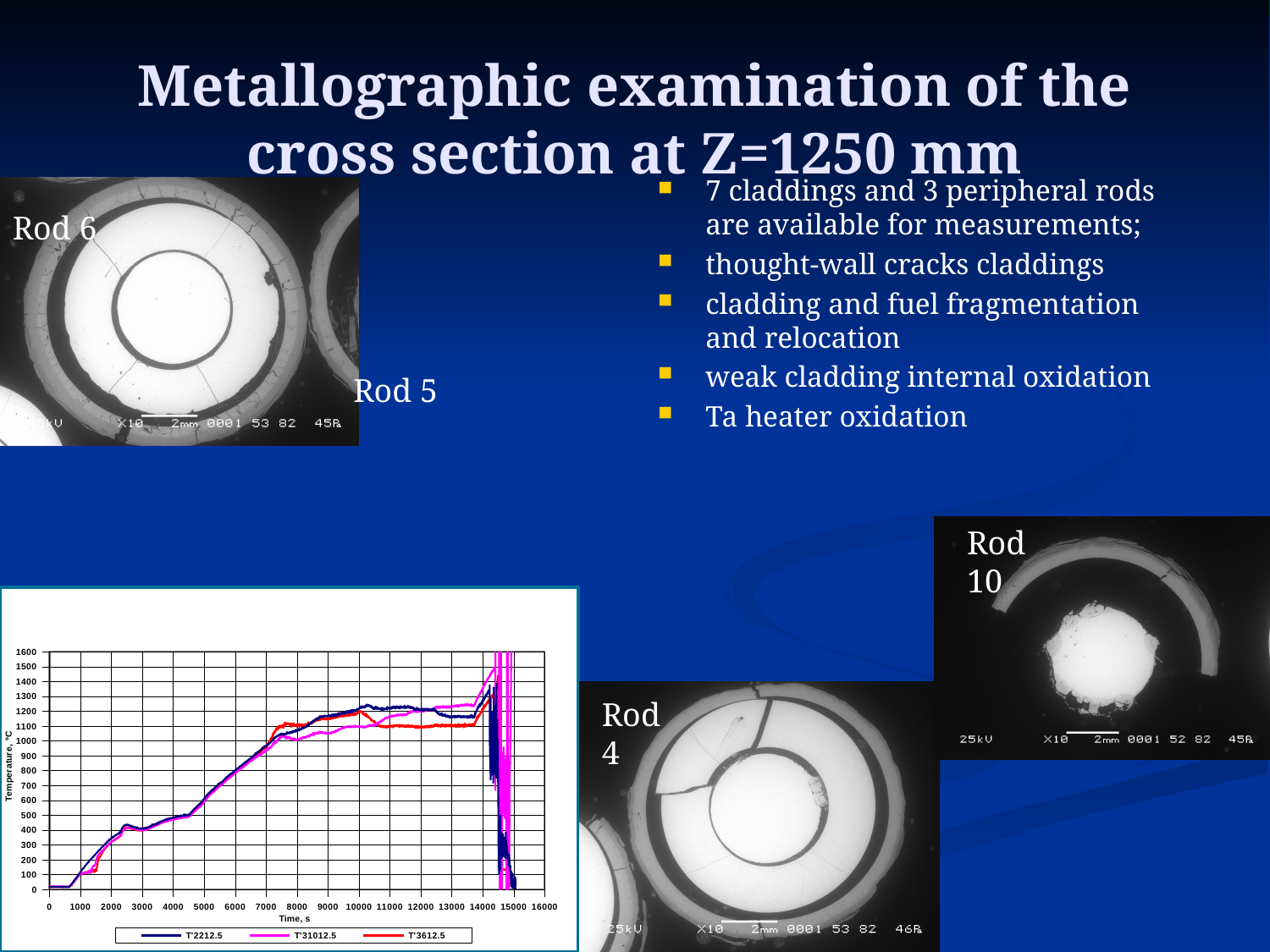
In the temperature chart, is the value for T'31012.5 at 13000 s greater or less than 1000? greater In the temperature chart, is the value for T'2212.5 at 10000 s greater or less than 1000? greater What are the three series names listed in the legend of the temperature chart? T'2212.5, T'31012.5, T'3612.5 In the temperature chart, do the temperature values rise or fall between 0 s and 10000 s? rise In the temperature chart, is the value for T'2212.5 at 5000 s greater or less than 1000? less How many series does the legend of the temperature chart list? 3 What is the x-axis label of the temperature chart? Time, s What kind of chart is shown at the bottom left of the slide? line chart